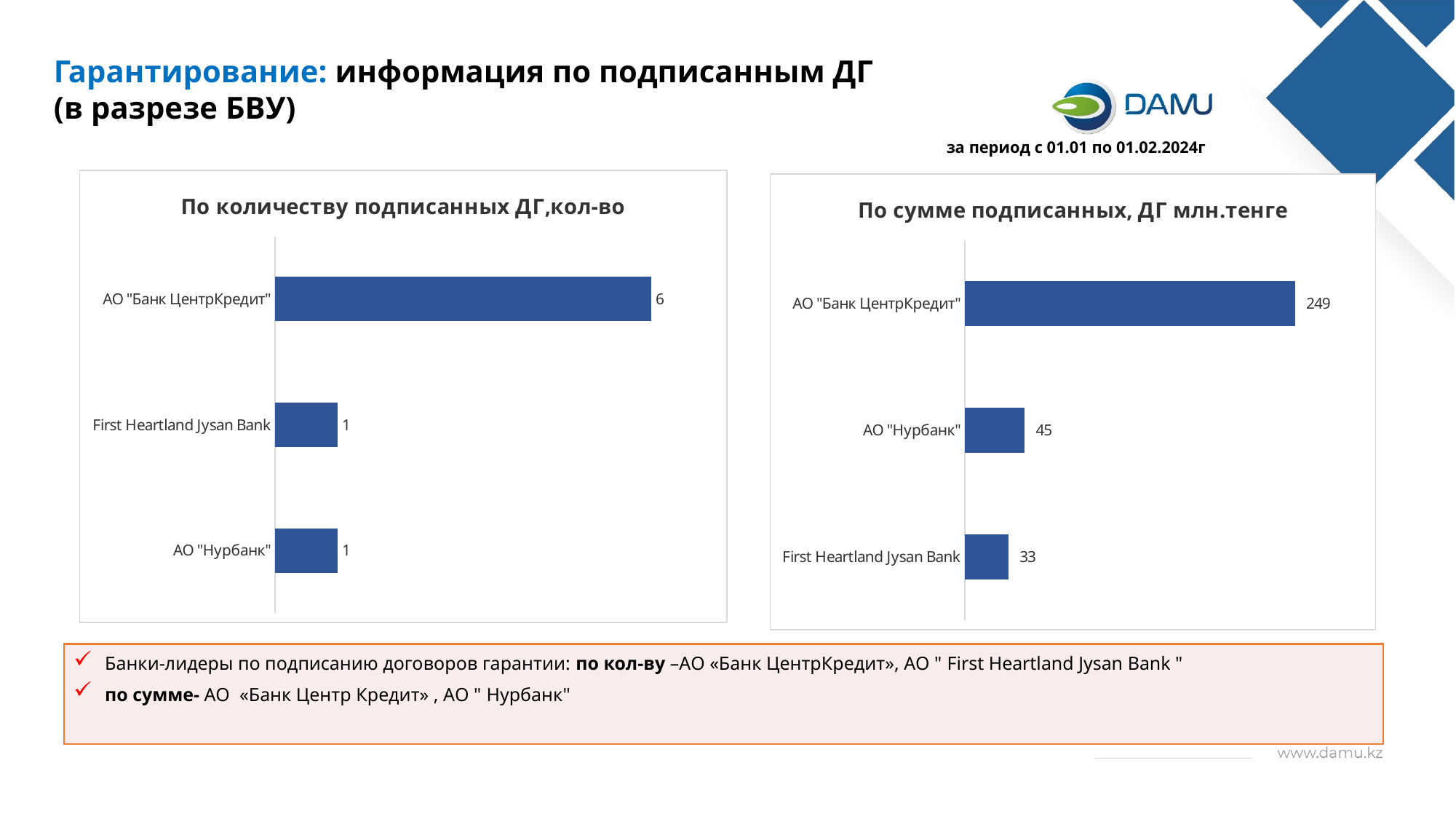
In the chart "По сумме подписанных, ДГ млн.тенге", what is the value for First Heartland Jysan Bank? 33 In the chart "По количеству подписанных ДГ,кол-во", which bank has the highest value? АО "Банк ЦентрКредит" In the chart "По сумме подписанных, ДГ млн.тенге", which is larger: АО "Нурбанк" or First Heartland Jysan Bank? АО "Нурбанк" How many banks are shown in the chart "По количеству подписанных ДГ,кол-во"? 3 What type of chart is "По сумме подписанных, ДГ млн.тенге"? Bar chart In the chart "По сумме подписанных, ДГ млн.тенге", which bank has the lowest value? First Heartland Jysan Bank In the chart "По сумме подписанных, ДГ млн.тенге", which bank has the highest value? АО "Банк ЦентрКредит" In the chart "По количеству подписанных ДГ,кол-во", what is the value for АО "Банк ЦентрКредит"? 6 In the chart "По сумме подписанных, ДГ млн.тенге", what is the difference between АО "Банк ЦентрКредит" and АО "Нурбанк"? 204 In the chart "По количеству подписанных ДГ,кол-во", what is the difference between АО "Банк ЦентрКредит" and АО "Нурбанк"? 5 In the chart "По количеству подписанных ДГ,кол-во", what is the value for First Heartland Jysan Bank? 1 In the chart "По сумме подписанных, ДГ млн.тенге", what is the value for АО "Нурбанк"? 45